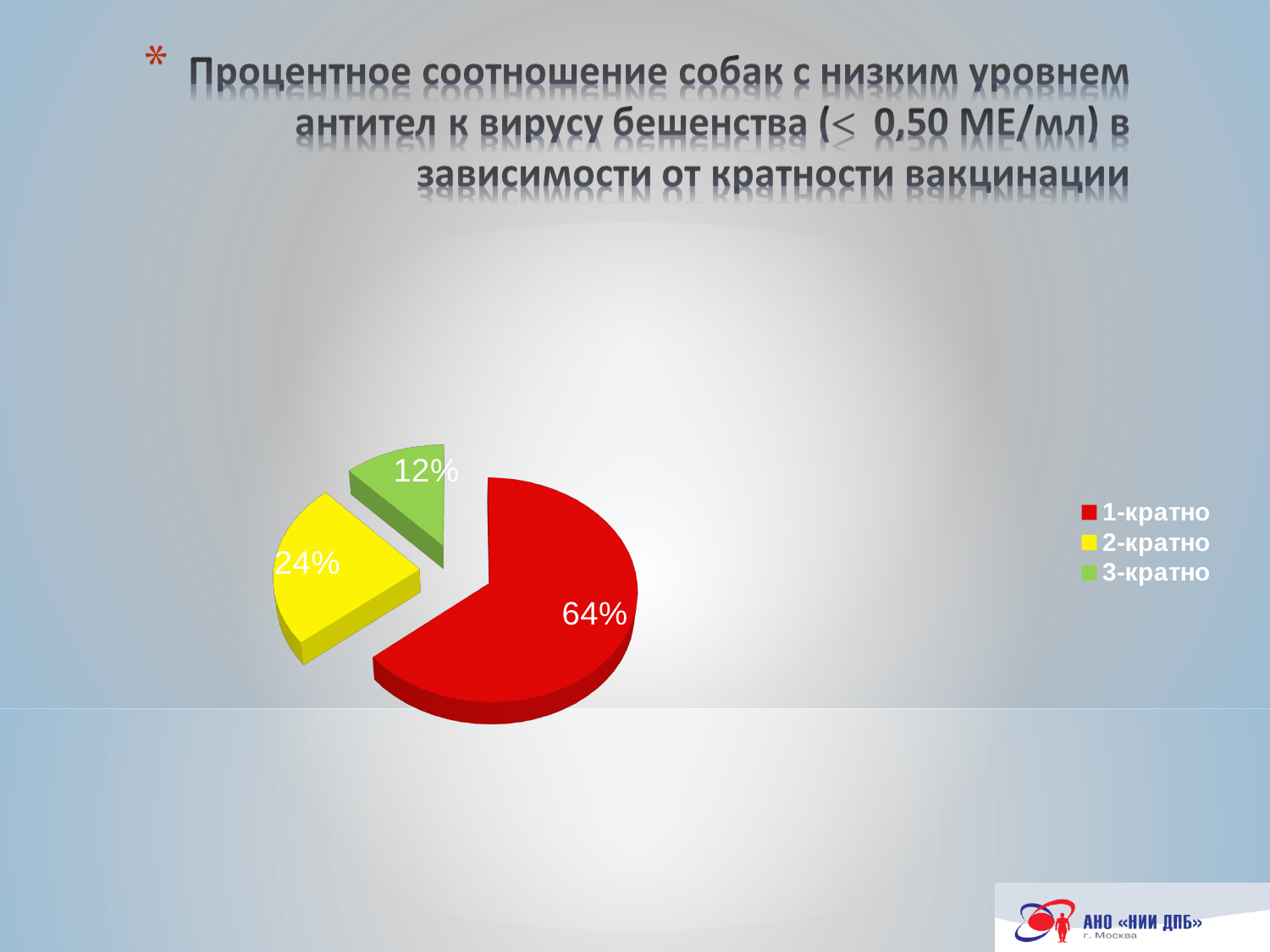
What percentage is shown for the 3-кратно slice? 12% How many slices does the pie chart have? 3 Which category has the largest share of the pie? 1-кратно Which category has the smallest share of the pie? 3-кратно What percentage is shown for the 2-кратно slice? 24% What kind of chart is shown on the slide? pie chart What percentage is shown for the 1-кратно slice? 64% How many entries does the legend list? 3 What is the difference in percentage points between the 2-кратно and 3-кратно slices? 12 Which slice is larger, 2-кратно or 3-кратно? 2-кратно What colour is the 1-кратно slice? red What is the difference in percentage points between the 1-кратно and 2-кратно slices? 40